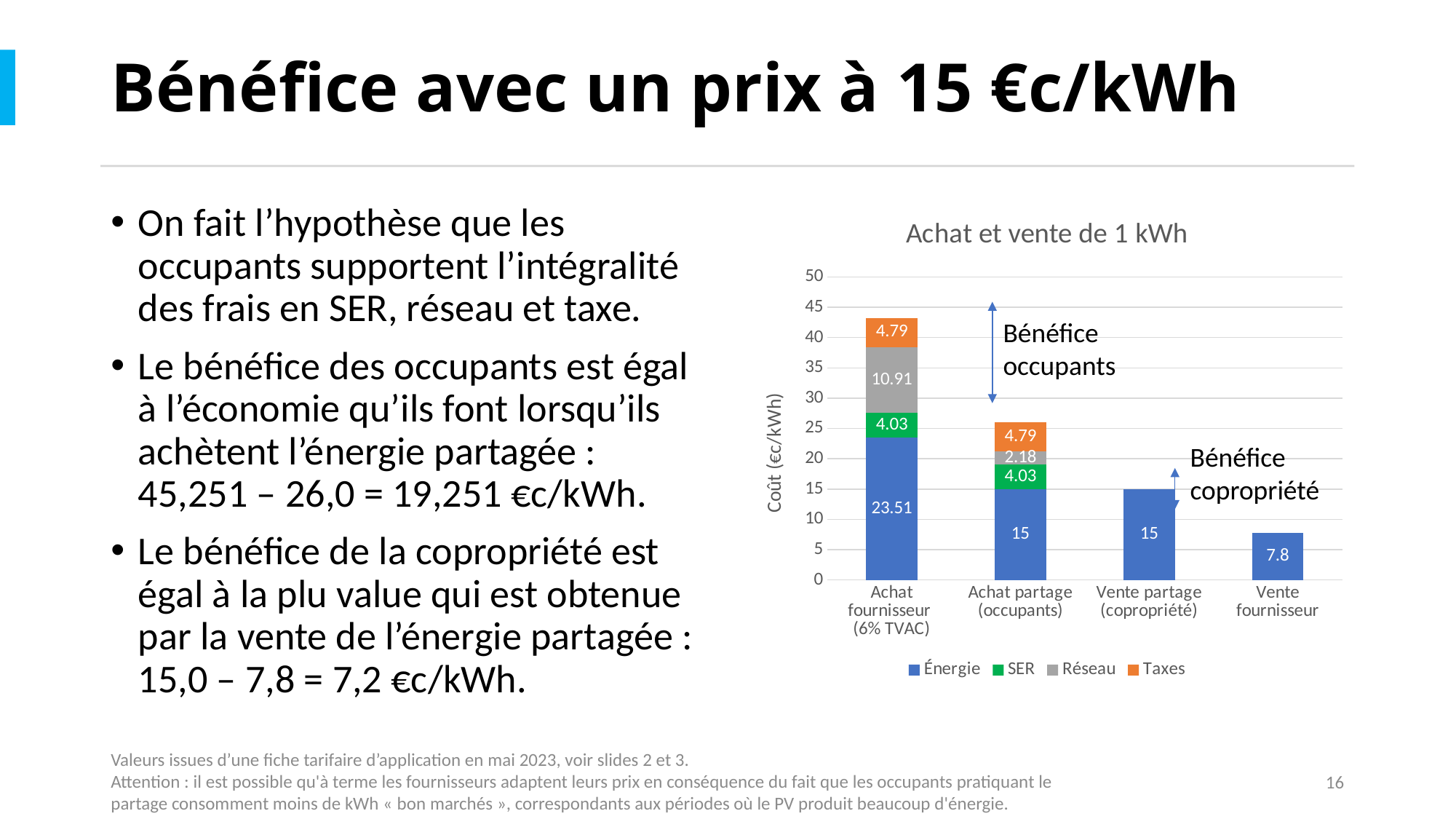
What is the difference between the Réseau values for Achat fournisseur (6% TVAC) and Achat partage (occupants)? 8.73 What is the title of the chart? Achat et vente de 1 kWh How many categories are shown on the x axis of the chart? 4 What is the Énergie value for Achat fournisseur (6% TVAC)? 23.51 What is the Réseau value for Achat partage (occupants)? 2.18 Which is larger, the Énergie value for Achat fournisseur (6% TVAC) or the Énergie value for Achat partage (occupants)? Achat fournisseur (6% TVAC) What is the total of the stacked bar for Achat partage (occupants)? 26 How many series does the chart legend list? 4 What is the Taxes value for Achat fournisseur (6% TVAC)? 4.79 What type of chart is shown on the slide? Stacked bar chart What is the value for Vente fournisseur? 7.8 Which category has the lowest total bar? Vente fournisseur